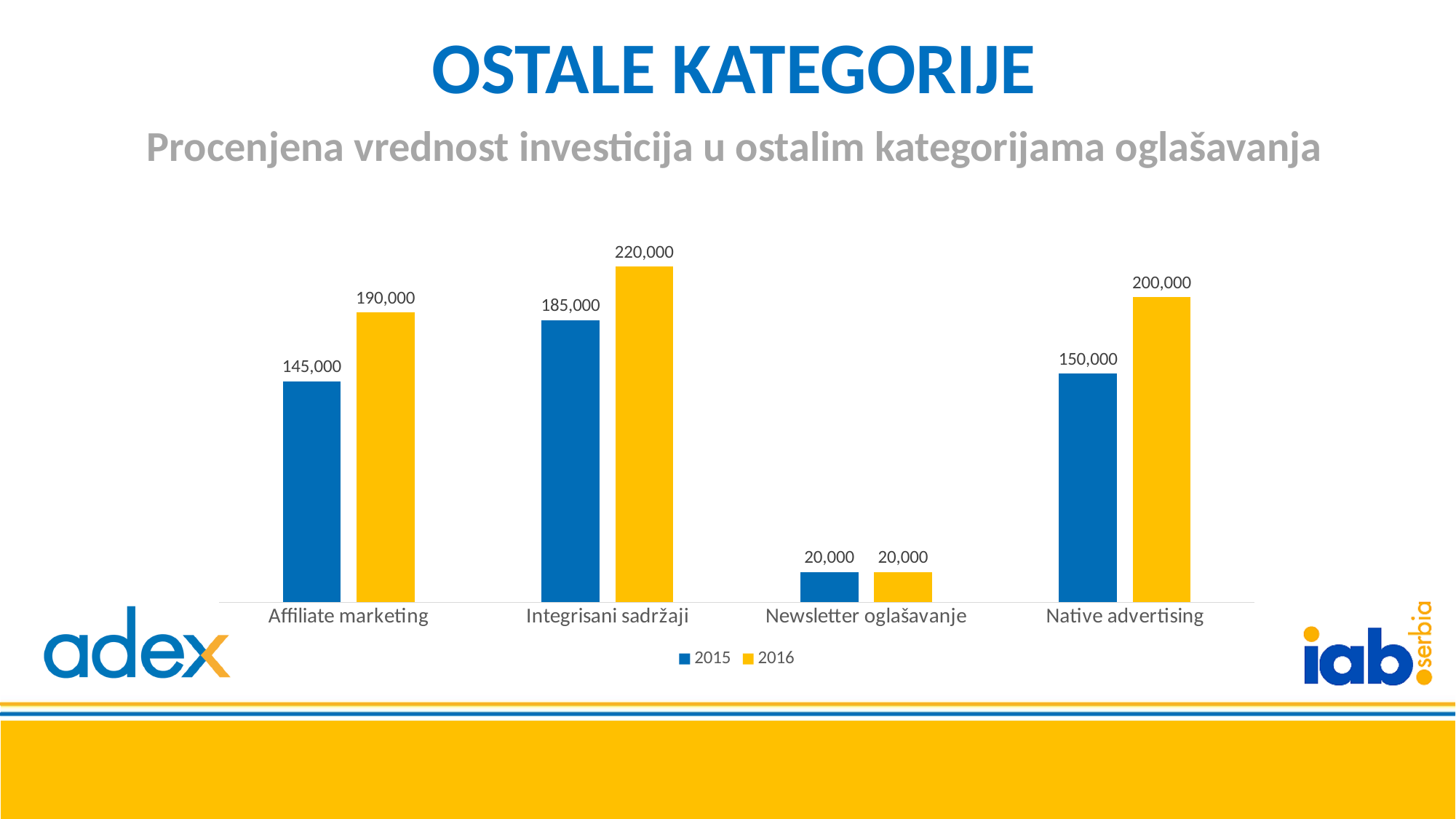
How many categories are shown on the x axis? 4 Which category has the lowest 2015 value? Newsletter oglašavanje What is the difference between the 2016 and 2015 values for Native advertising? 50,000 Which is larger, the 2015 value for Integrisani sadržaji or the 2015 value for Native advertising? Integrisani sadržaji How many series does the legend list? 2 What kind of chart is shown on the slide? Bar chart What is the 2015 value for Newsletter oglašavanje? 20,000 What is the 2016 value for Native advertising? 200,000 What is the difference between the 2016 and 2015 values for Affiliate marketing? 45,000 What is the 2015 value for Affiliate marketing? 145,000 What is the 2016 value for Integrisani sadržaji? 220,000 Which category has the highest 2016 value? Integrisani sadržaji